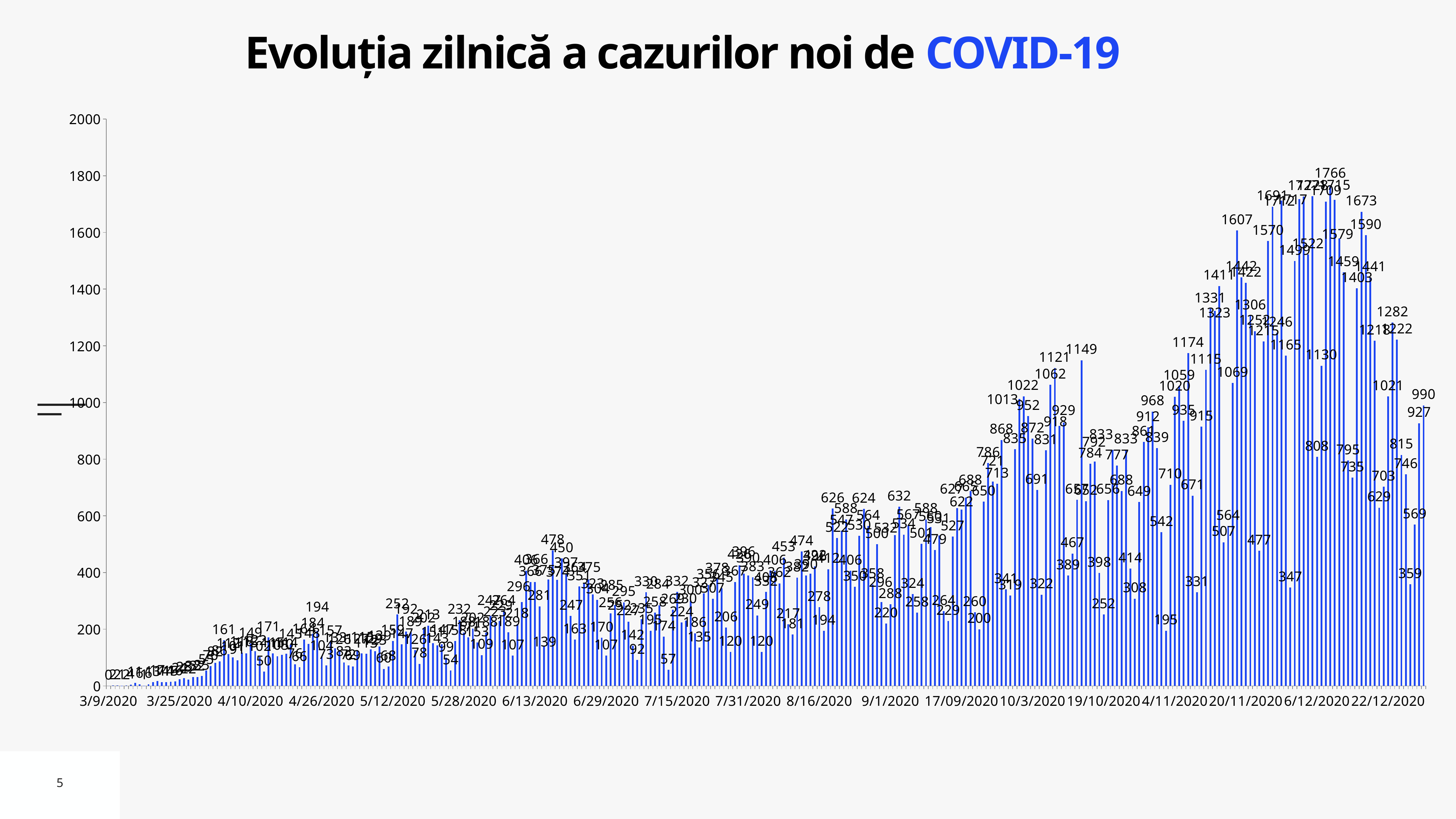
What is the difference between the bars labelled 1766 and 1673? 93 What is the first date label on the x axis? 3/9/2020 Overall, do the daily values rise or fall from left to right along the x axis? rise Is the highest bar on the chart greater or less than 1600? greater What is the value of the rightmost (last) bar on the chart? 927 What is the title of the chart? Evoluția zilnică a cazurilor noi de COVID-19 What kind of chart is shown on the slide? bar chart What is the highest daily value labelled on the chart? 1766 What is the maximum value shown on the vertical axis? 2000 Is the highest bar on the chart greater or less than 1800? less Which is larger, the bar labelled 1766 or the bar labelled 1673? 1766 What is the last date label on the x axis? 22/12/2020